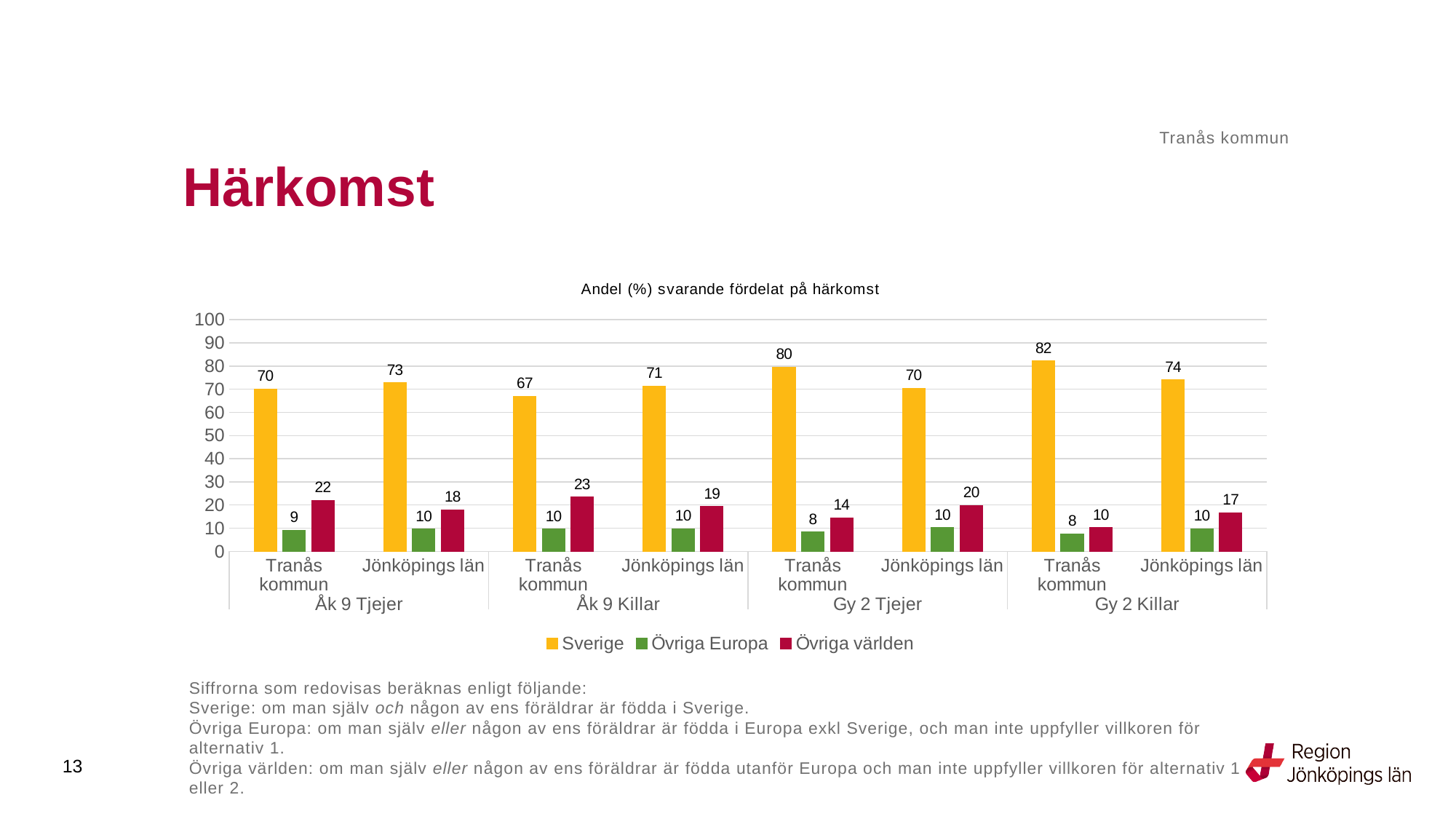
What is the value for Övriga världen for Jönköpings län in the Gy 2 Tjejer group? 20 Which is larger: the Övriga världen value for Tranås kommun in Åk 9 Killar or in Gy 2 Killar? Åk 9 Killar How many series does the legend list? 3 Is the Sverige value for Jönköpings län in the Gy 2 Killar group greater or less than 70? greater What is the difference between the Sverige values for Tranås kommun and Jönköpings län in the Gy 2 Tjejer group? 10 What kind of chart is shown on the slide? Bar chart How many groups (Åk 9 Tjejer, Åk 9 Killar, etc.) are shown on the x axis? 4 Which group and category has the lowest Sverige value? Tranås kommun, Åk 9 Killar What is the value for Sverige for Tranås kommun in the Åk 9 Tjejer group? 70 What is the title of the chart? Andel (%) svarande fördelat på härkomst Which group and category has the highest Sverige value? Tranås kommun, Gy 2 Killar What is the value for Övriga Europa for Tranås kommun in the Gy 2 Killar group? 8